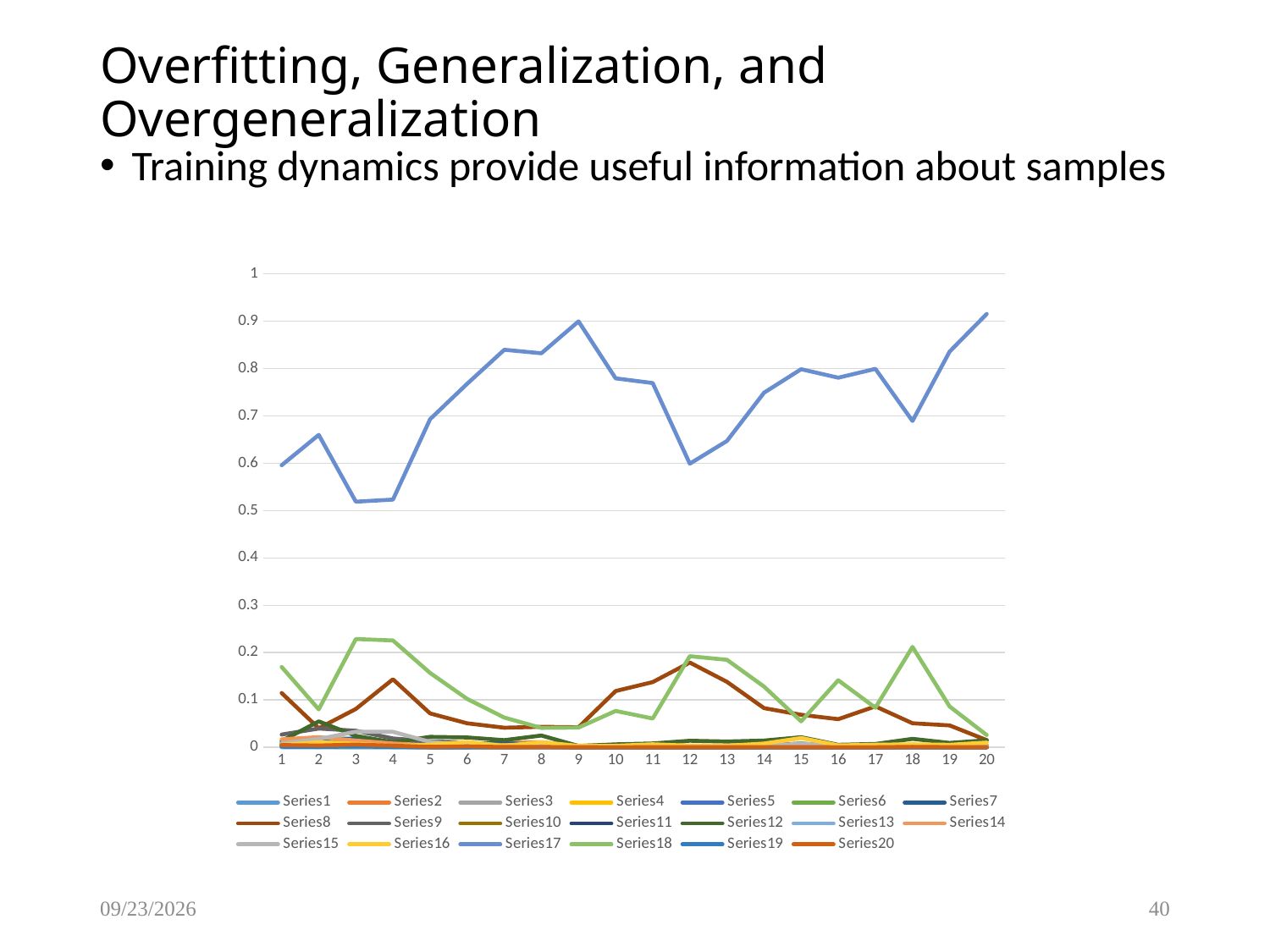
What is the label of the first entry in the legend? Series1 For the topmost line, is the value at x = 2 or at x = 3 larger? x = 2 What is the highest value shown on the y axis? 1 Is the value of the topmost line at x = 20 greater or less than 0.8? greater Does the topmost line rise or fall between x = 4 and x = 9? rise Is the value of the topmost line at x = 12 greater or less than 0.7? less Is the value of the topmost line at x = 9 greater or less than 0.8? greater What kind of chart is shown on the slide? line chart Does the topmost line rise or fall between x = 9 and x = 12? fall How many series does the legend list? 20 How many points are there along the x axis? 20